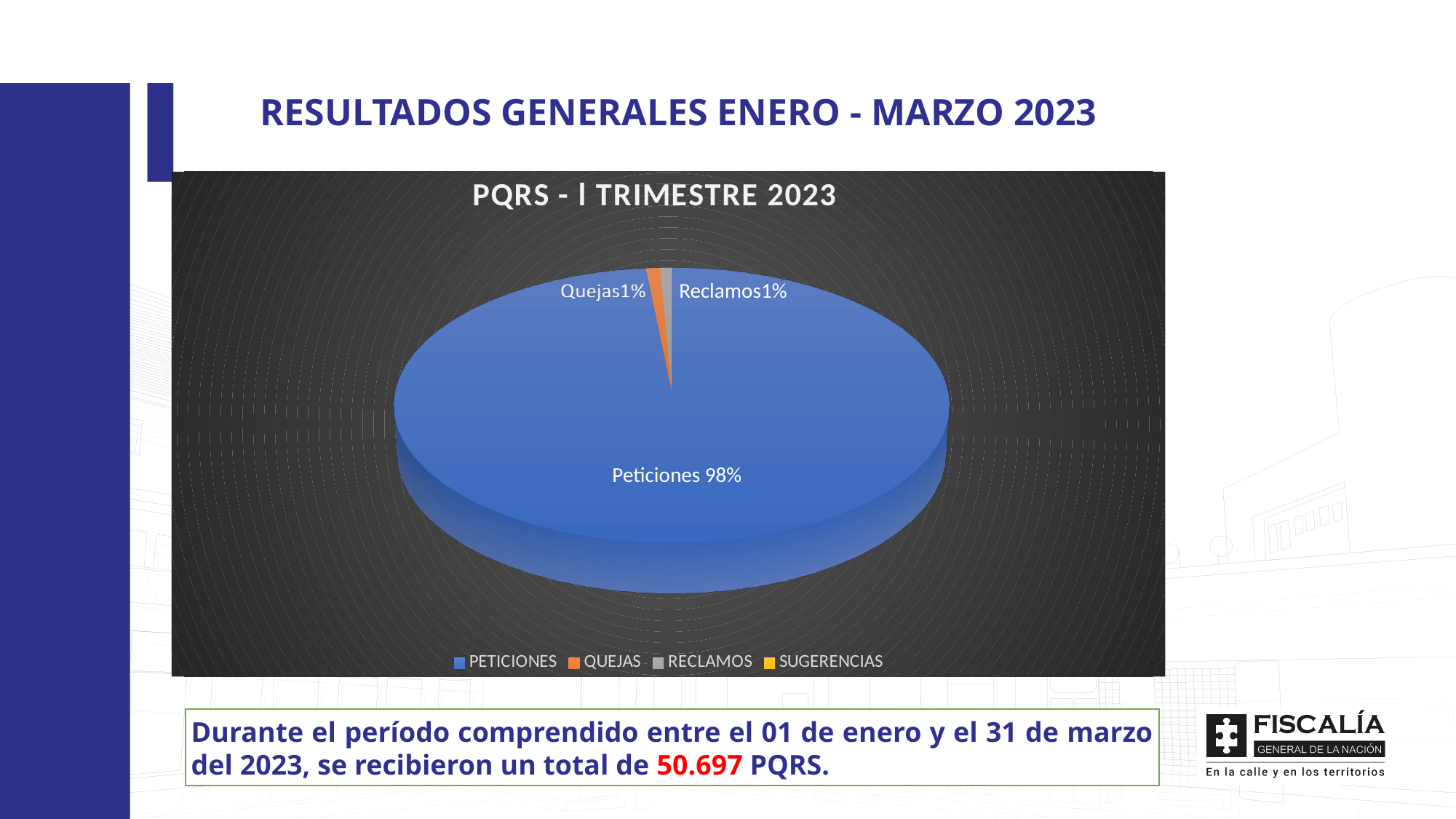
What kind of chart is shown on the slide? pie chart What is the title of the chart? PQRS - I TRIMESTRE 2023 What share of the pie does Quejas represent? 1% Which is larger, the share for Peticiones or the share for Quejas? Peticiones What is the difference between the share for Peticiones and the share for Reclamos? 97% Is the share for Peticiones greater or less than 50%? greater Which category has the largest slice of the pie? Peticiones Which legend entry is shown in yellow? SUGERENCIAS What share of the pie does Peticiones represent? 98% How many slices have a percentage label printed on the chart? 3 What share of the pie does Reclamos represent? 1% How many categories does the legend list? 4